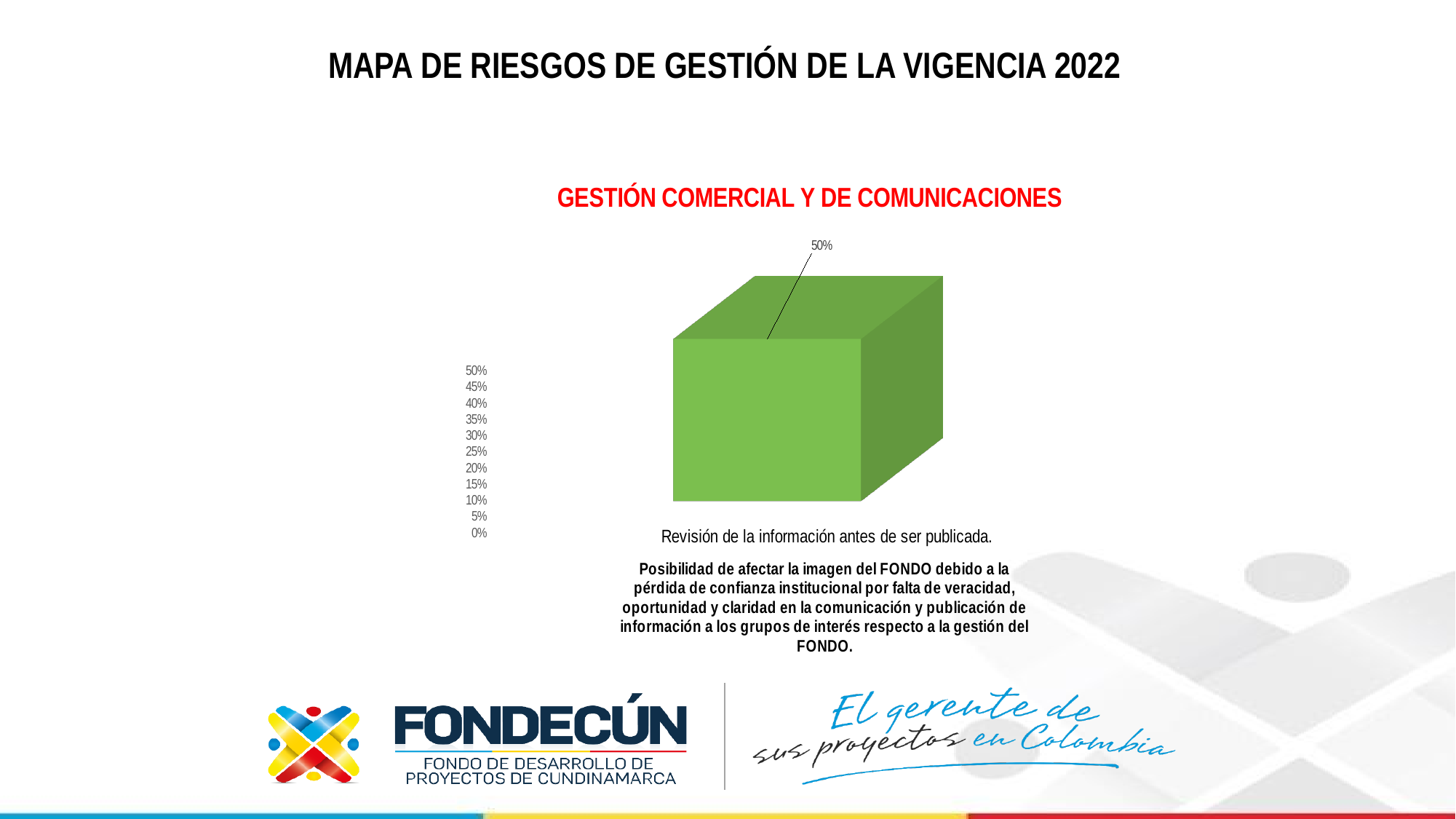
What kind of chart is shown on the slide? bar chart What is the value shown for "Revisión de la información antes de ser publicada."? 50% What is the lowest tick value shown on the vertical axis? 0% What colour is the bar in the chart? green What is the title of the chart? GESTIÓN COMERCIAL Y DE COMUNICACIONES What is the category label of the single bar in the chart? Revisión de la información antes de ser publicada. Is the value for "Revisión de la información antes de ser publicada." greater or less than 25%? greater What is the highest tick value shown on the vertical axis? 50% How many bars does the chart show? 1 Is the value for "Revisión de la información antes de ser publicada." greater or less than 40%? greater